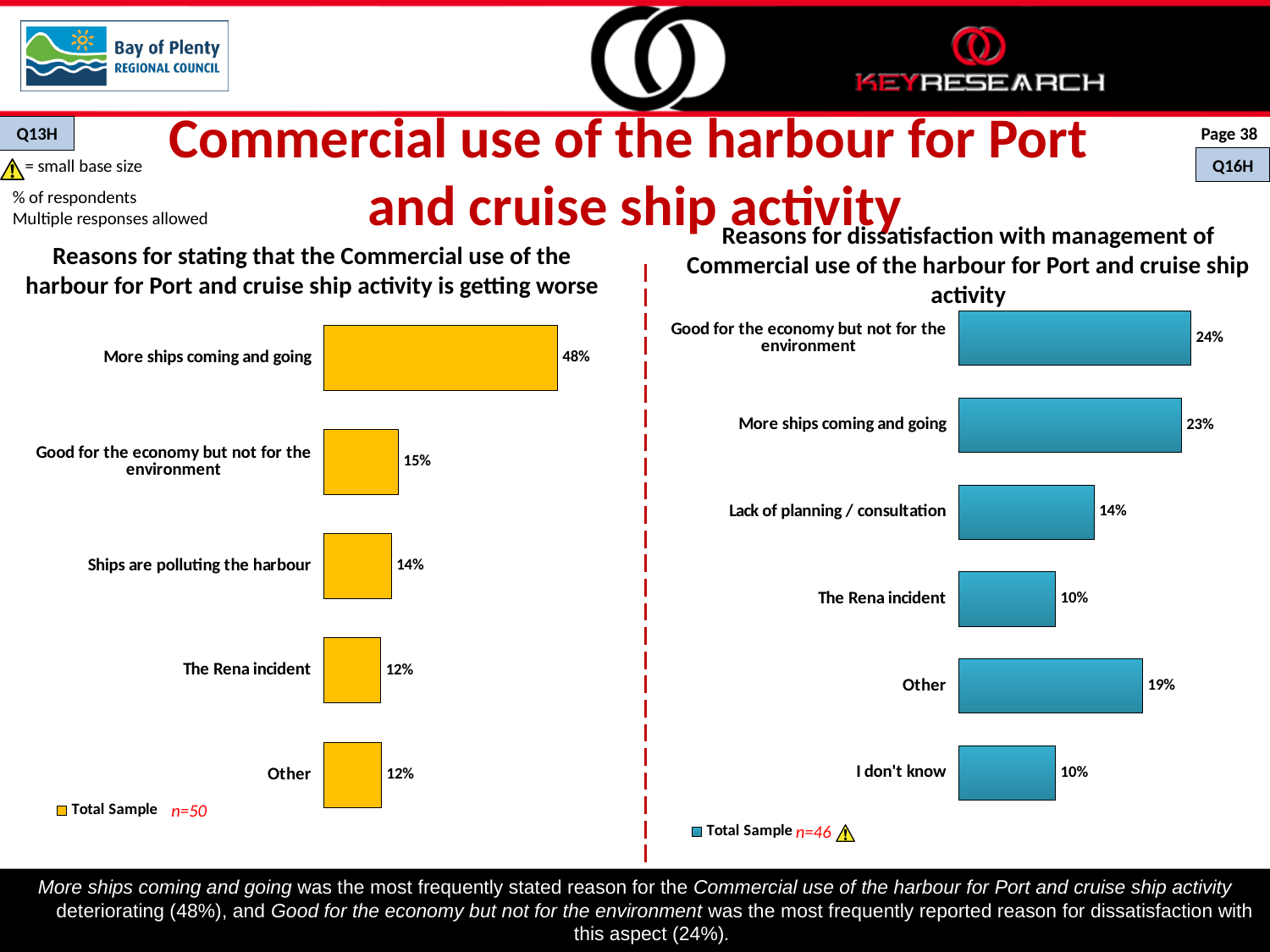
In the left chart, which reason has the highest percentage? More ships coming and going In the left chart, what percentage of respondents gave 'More ships coming and going' as a reason? 48% In the right chart, which reason has the highest percentage? Good for the economy but not for the environment In the right chart, what percentage is shown for 'Lack of planning / consultation'? 14% In the left chart, what is the difference between 'More ships coming and going' and 'Good for the economy but not for the environment'? 33 percentage points How many categories are shown in the right chart? 6 In the right chart, what is the difference between 'Other' and 'The Rena incident'? 9 percentage points What type of chart is used on the left side of the slide? Bar chart In the left chart, what is the value for 'Ships are polluting the harbour'? 14% How many categories are shown in the left chart? 5 In the right chart, what is the value for 'Other'? 19% In the right chart, which is larger: 'Other' or 'Lack of planning / consultation'? Other